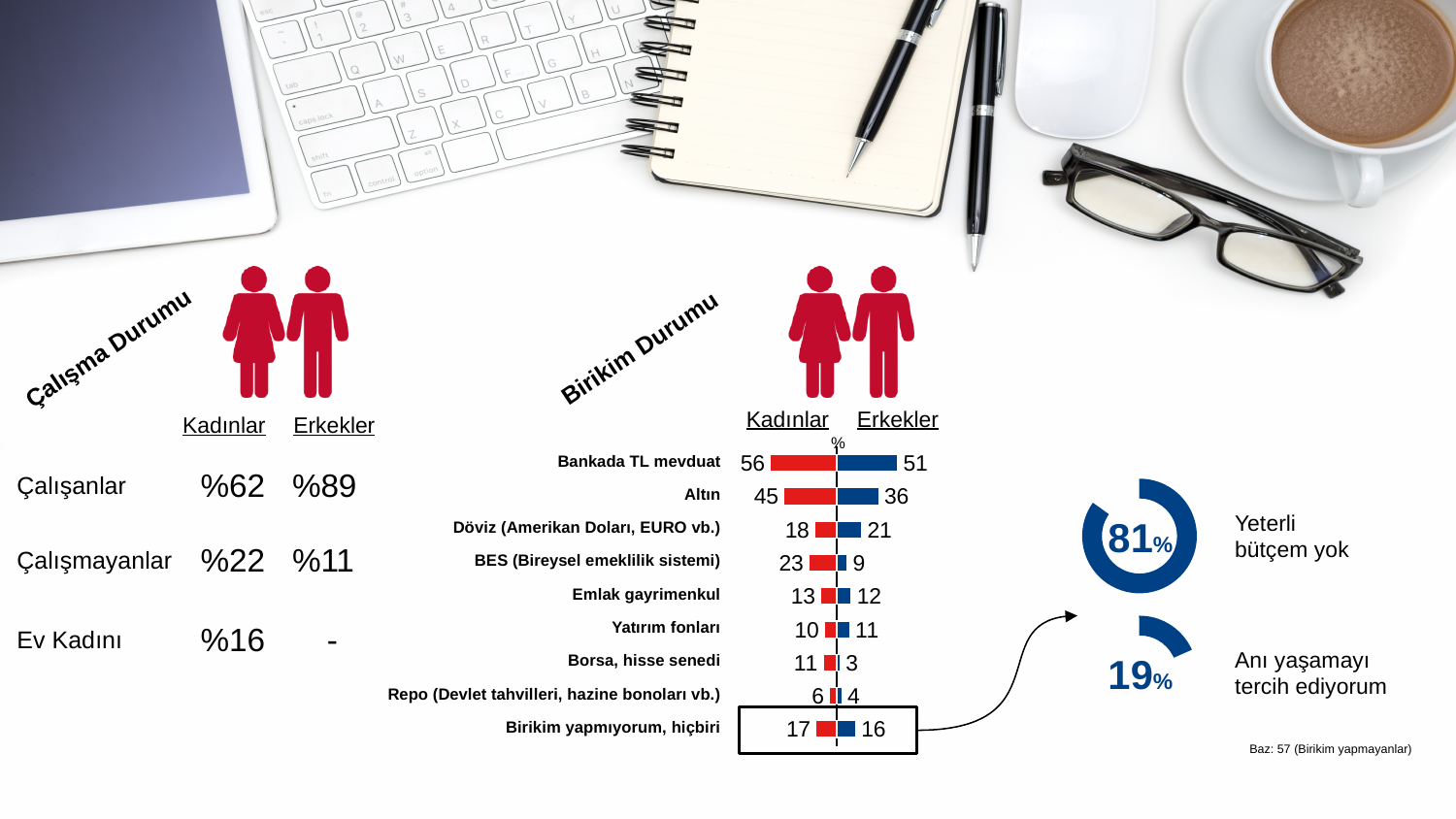
In the Birikim Durumu chart, what is the value for Erkekler for Altın? 36 What kind of chart is the Birikim Durumu chart? bar chart In the Birikim Durumu chart, which colour represents Kadınlar? red In the Birikim Durumu chart, what is the difference between Kadınlar and Erkekler for BES (Bireysel emeklilik sistemi)? 14 In the Birikim Durumu chart, how many series are shown? 2 In the Birikim Durumu chart, which is larger for Döviz (Amerikan Doları, EURO vb.): Kadınlar or Erkekler? Erkekler In the Birikim Durumu chart, what is the value for Kadınlar for Bankada TL mevduat? 56 In the donut charts on the right, what percentage corresponds to 'Yeterli bütçem yok'? 81% In the Birikim Durumu chart, what is the value for Erkekler for BES (Bireysel emeklilik sistemi)? 9 In the Birikim Durumu chart, which category has the highest value for Kadınlar? Bankada TL mevduat In the Birikim Durumu chart, which category has the lowest value for Erkekler? Borsa, hisse senedi In the Birikim Durumu chart, how many categories are shown? 9